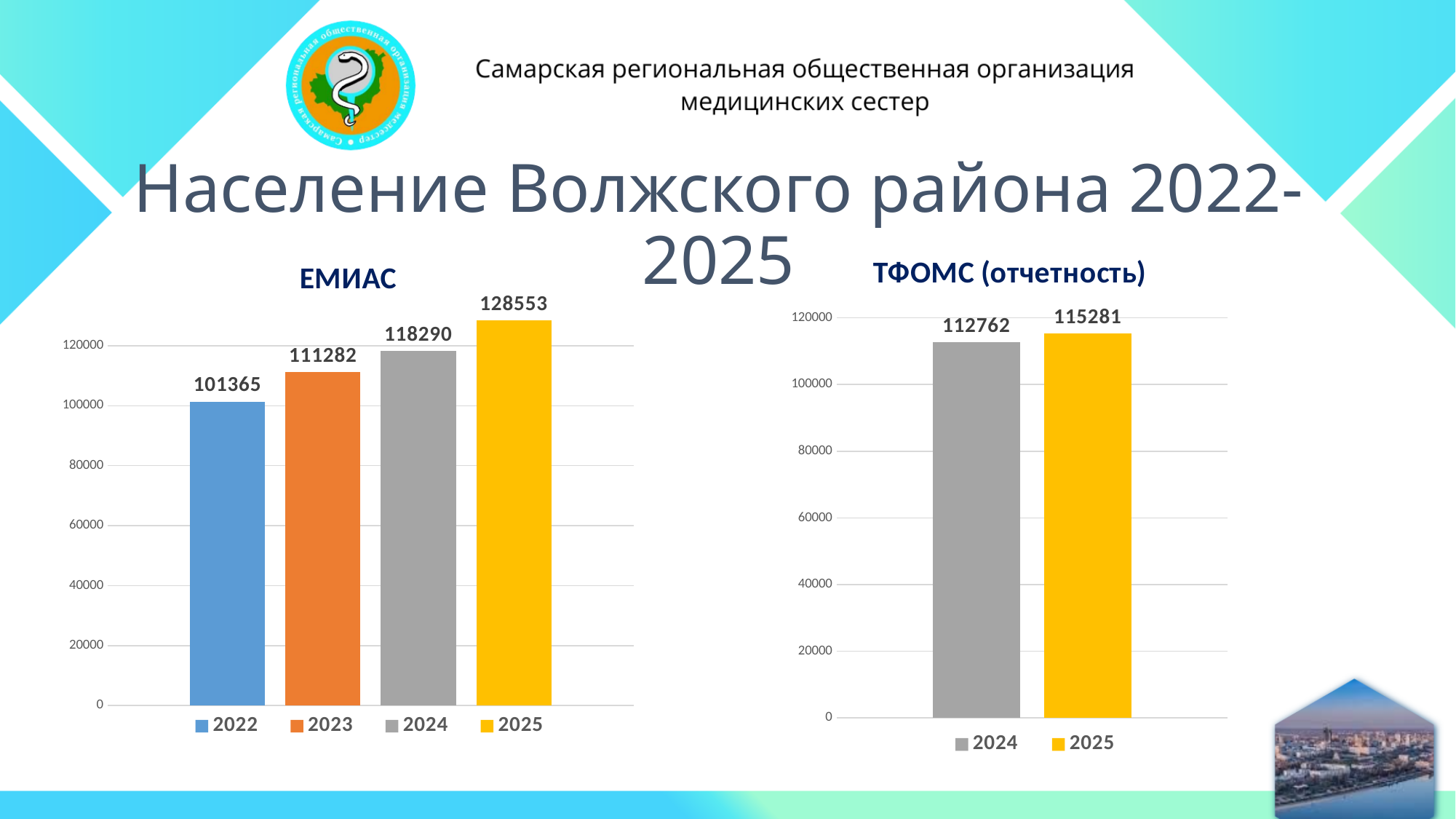
In the ТФОМС (отчетность) chart, what is the value for 2025? 115281 In the ЕМИАС chart, is the value for 2025 greater or less than 120000? greater In the ЕМИАС chart, which is larger, the value for 2023 or the value for 2024? 2024 In the ТФОМС (отчетность) chart, what is the difference between the values for 2025 and 2024? 2519 In the ЕМИАС chart, which year has the highest value? 2025 In the ЕМИАС chart, what is the value for 2022? 101365 In the ЕМИАС chart, which year has the lowest value? 2022 In the ЕМИАС chart, what is the value for 2024? 118290 Do the values in the ЕМИАС chart rise or fall from 2022 to 2025? rise How many bars are shown in the ТФОМС (отчетность) chart? 2 How many entries does the legend of the ЕМИАС chart list? 4 In the ЕМИАС chart, what is the difference between the values for 2025 and 2022? 27188